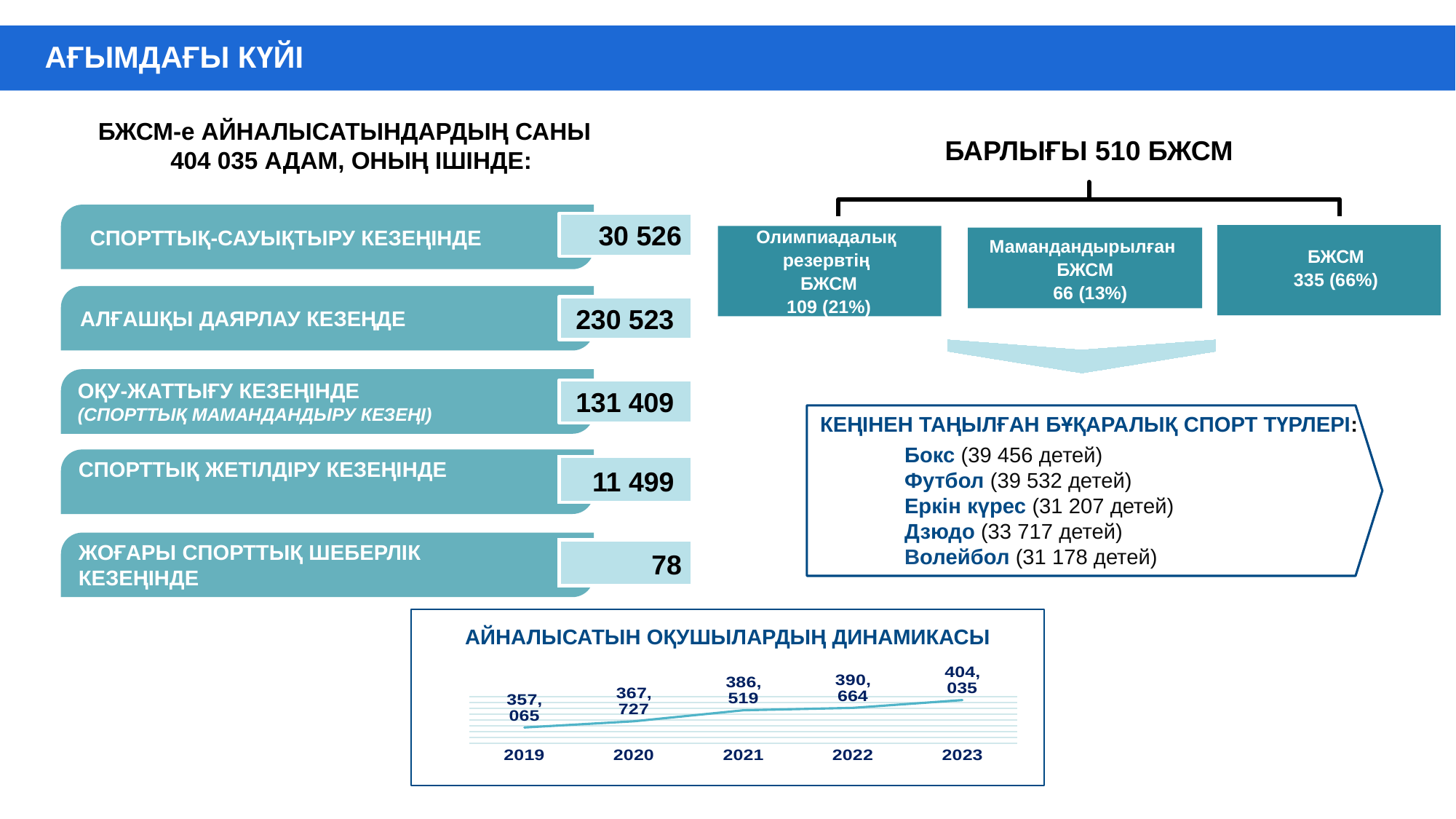
In the chart titled "АЙНАЛЫСАТЫН ОҚУШЫЛАРДЫҢ ДИНАМИКАСЫ", what is the value for 2021? 386,519 In the chart titled "АЙНАЛЫСАТЫН ОҚУШЫЛАРДЫҢ ДИНАМИКАСЫ", which year has the larger value, 2020 or 2022? 2022 In the chart titled "АЙНАЛЫСАТЫН ОҚУШЫЛАРДЫҢ ДИНАМИКАСЫ", do the values rise or fall from 2019 to 2023? Rise In the chart titled "АЙНАЛЫСАТЫН ОҚУШЫЛАРДЫҢ ДИНАМИКАСЫ", how many years are plotted? 5 In the chart titled "АЙНАЛЫСАТЫН ОҚУШЫЛАРДЫҢ ДИНАМИКАСЫ", what is the value for 2019? 357,065 What kind of chart is the one titled "АЙНАЛЫСАТЫН ОҚУШЫЛАРДЫҢ ДИНАМИКАСЫ"? Line chart In the chart titled "АЙНАЛЫСАТЫН ОҚУШЫЛАРДЫҢ ДИНАМИКАСЫ", what is the value for 2023? 404,035 In the chart titled "АЙНАЛЫСАТЫН ОҚУШЫЛАРДЫҢ ДИНАМИКАСЫ", which year has the lowest value? 2019 In the chart titled "АЙНАЛЫСАТЫН ОҚУШЫЛАРДЫҢ ДИНАМИКАСЫ", what is the value for 2022? 390,664 In the chart titled "АЙНАЛЫСАТЫН ОҚУШЫЛАРДЫҢ ДИНАМИКАСЫ", what is the difference between the values for 2021 and 2020? 18,792 In the chart titled "АЙНАЛЫСАТЫН ОҚУШЫЛАРДЫҢ ДИНАМИКАСЫ", what is the difference between the values for 2023 and 2019? 46,970 In the chart titled "АЙНАЛЫСАТЫН ОҚУШЫЛАРДЫҢ ДИНАМИКАСЫ", which year has the highest value? 2023